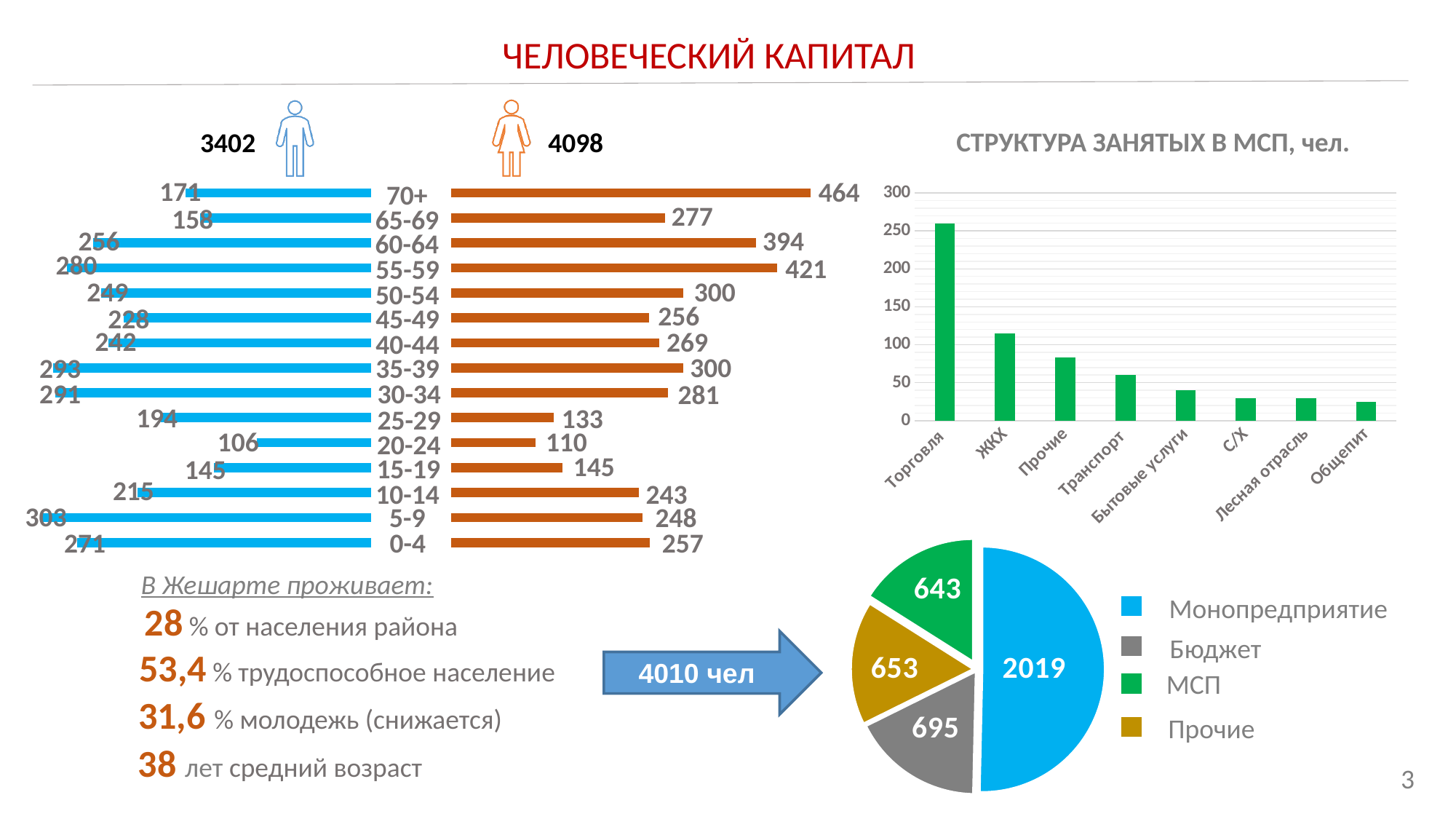
In the pie chart at the bottom right, which is larger: Монопредприятие or Прочие? Монопредприятие In the population pyramid on the left, what is the difference between the women's and men's values for the 70+ age group? 293 In the pie chart at the bottom right, what is the value for Бюджет? 695 In the chart titled 'СТРУКТУРА ЗАНЯТЫХ В МСП, чел.', is the value for Торговля greater or less than 250? greater In the population pyramid on the left, which age group has the lowest value for women? 20-24 In the chart titled 'СТРУКТУРА ЗАНЯТЫХ В МСП, чел.', how many categories are shown? 8 In the population pyramid on the left, which age group has the highest value for men? 5-9 In the chart titled 'СТРУКТУРА ЗАНЯТЫХ В МСП, чел.', which category has the highest value? Торговля In the population pyramid on the left, how many age groups are shown? 15 In the population pyramid on the left, what is the value for women in the 55-59 age group? 421 What kind of chart is the chart titled 'СТРУКТУРА ЗАНЯТЫХ В МСП, чел.'? bar chart In the population pyramid on the left, what is the value for men in the 70+ age group? 171